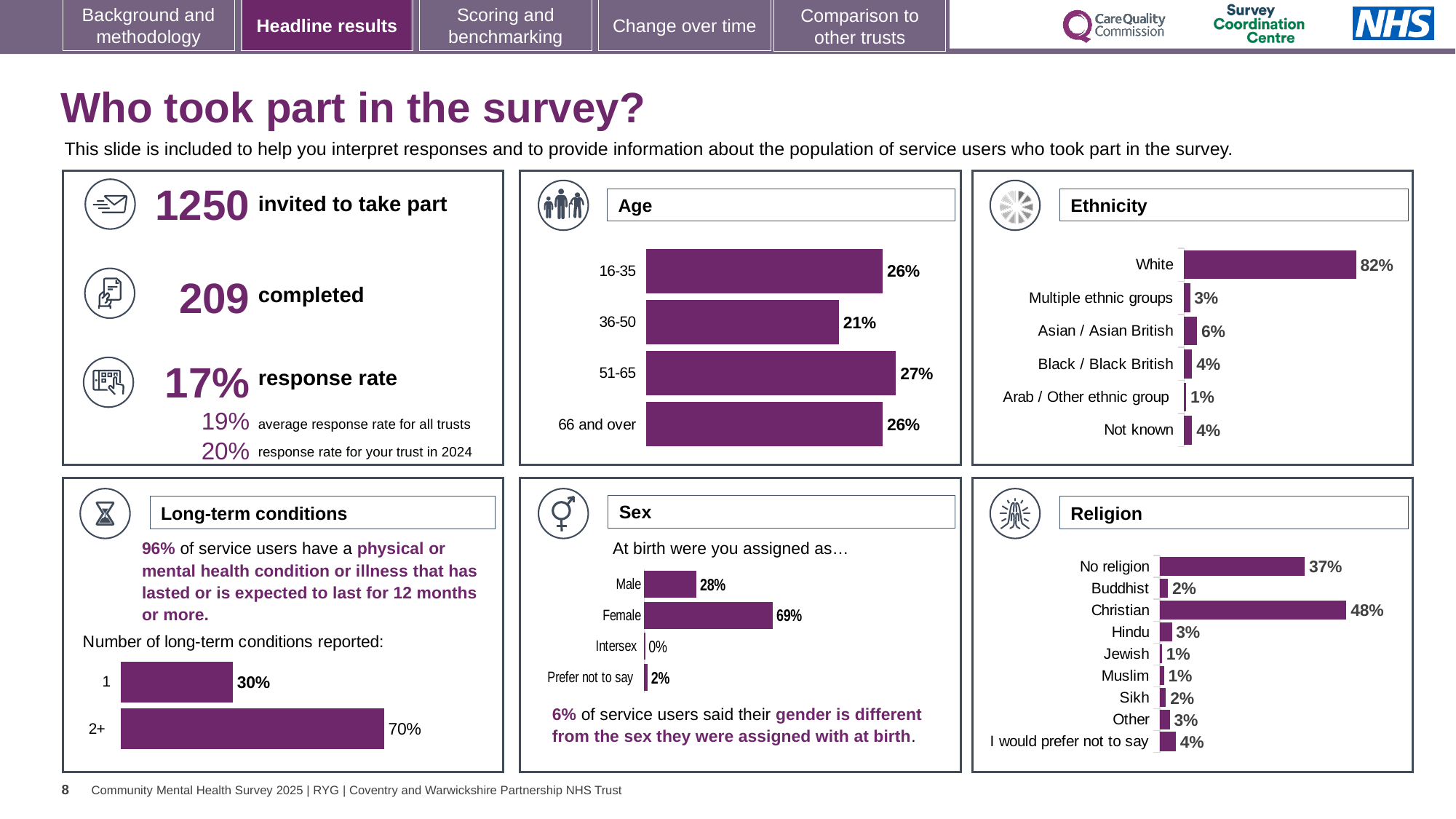
What type of chart is used in the Age panel? Bar chart In the Sex chart, which is larger, Male or Female? Female In the Religion chart, which religion category has the highest percentage? Christian In the Ethnicity chart, what is the difference between the Asian / Asian British and Black / Black British percentages? 2% How many categories are shown in the Religion chart? 9 In the Age chart, what percentage of respondents were aged 51-65? 27% In the Age chart, which age group has the lowest percentage? 36-50 In the Ethnicity chart, what percentage of respondents were White? 82% In the Sex chart, what percentage of respondents were assigned Female at birth? 69% How many categories are shown in the Ethnicity chart? 6 In the Long-term conditions chart, what percentage of service users reported 2+ long-term conditions? 70% In the Religion chart, what percentage of respondents reported No religion? 37%